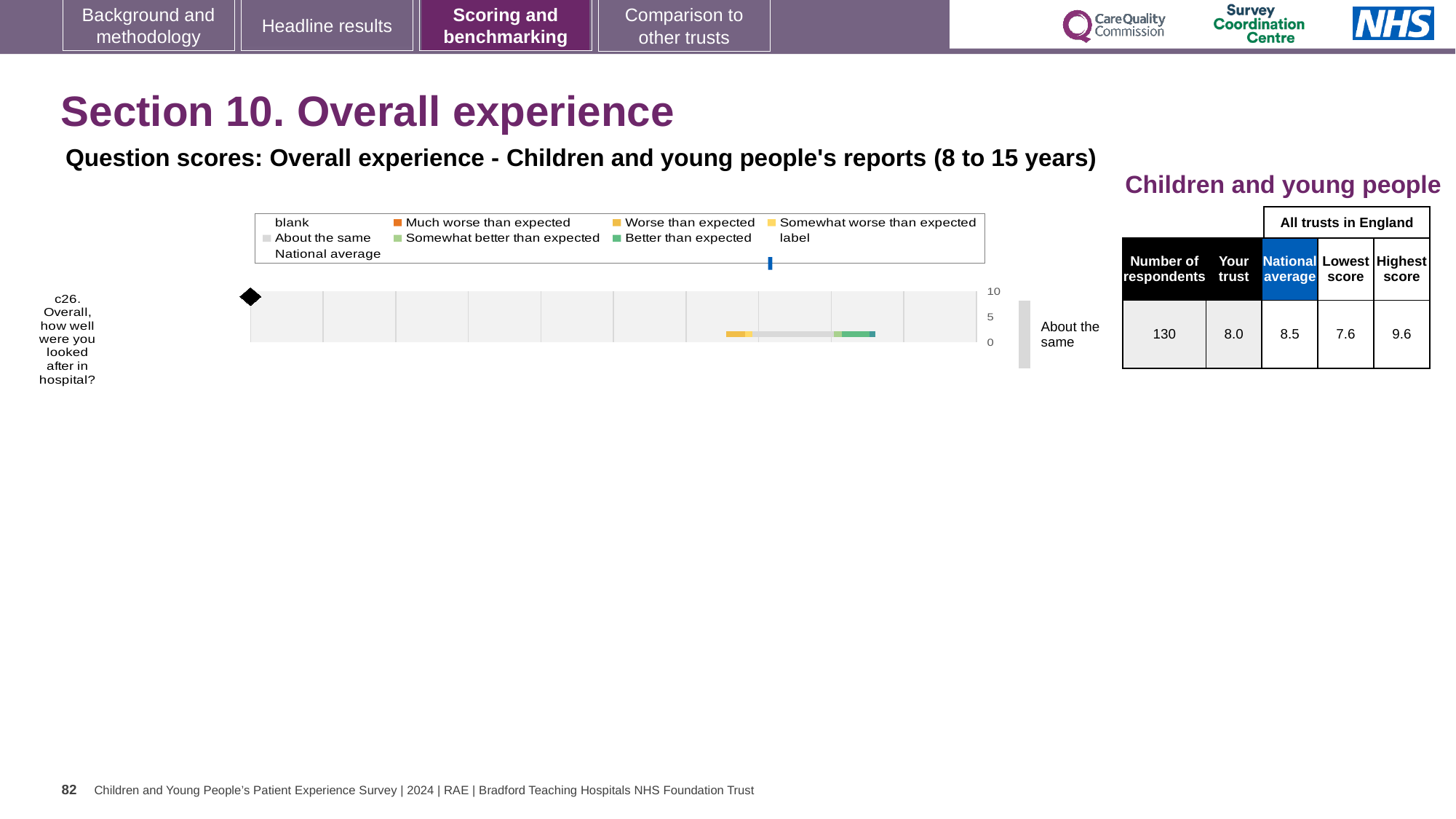
What is the highest score among all trusts in England for c26? 9.6 What is the text of the question plotted in the chart? c26. Overall, how well were you looked after in hospital? What is the lowest score among all trusts in England for c26? 7.6 What is the 'Your trust' score for c26? 8.0 What kind of chart is used to show the c26 question score? bar chart What is the difference between the highest and lowest scores for c26? 2.0 What benchmark category label is shown to the right of the bar for c26? About the same What is the national average score for c26? 8.5 How many respondents answered c26? 130 Is the trust score for c26 greater or less than 5? greater Which is larger for c26, the trust score or the national average? national average How many survey questions are plotted in the chart? 1